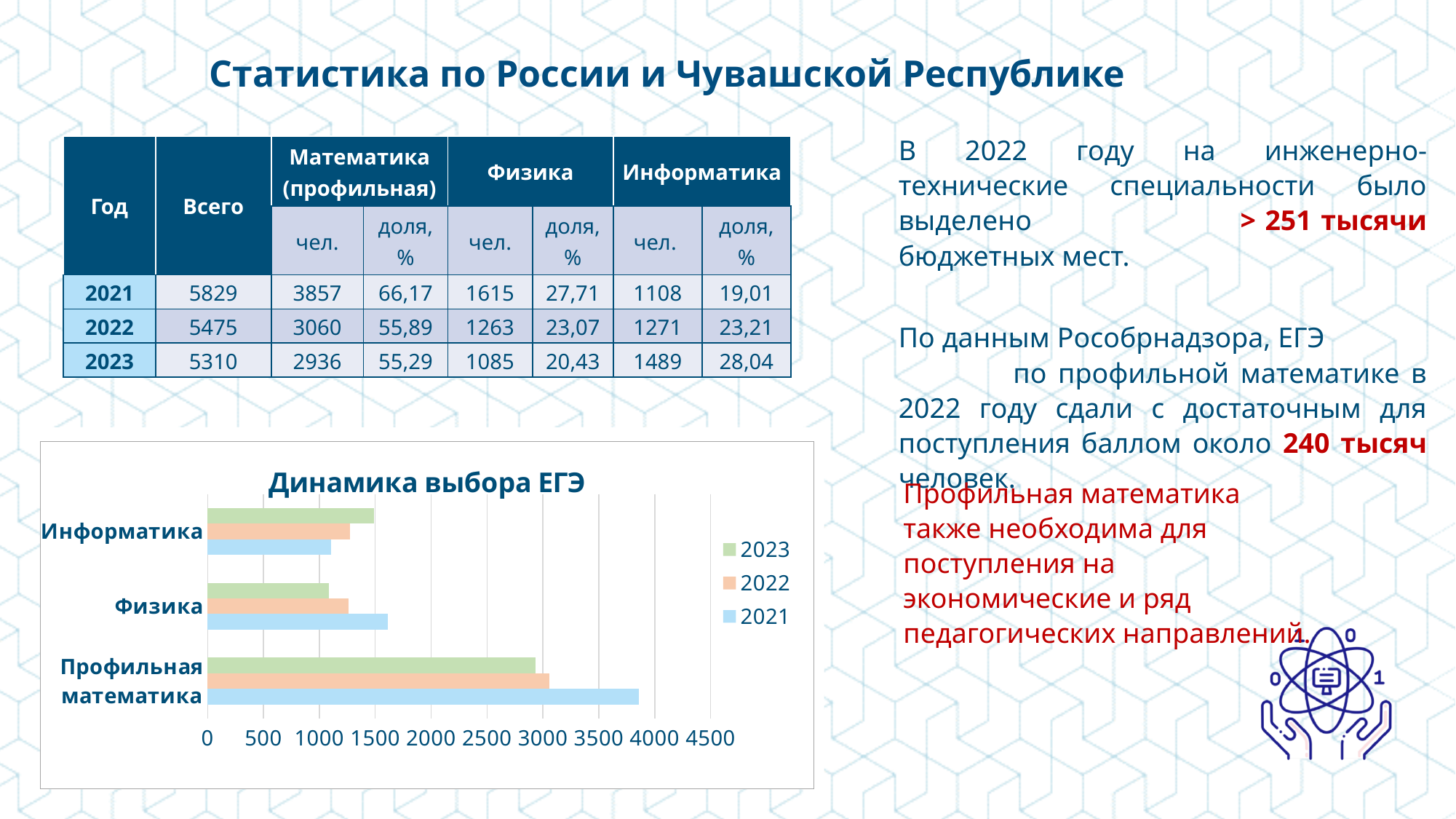
For Информатика, do the values rise or fall from 2021 to 2023? rise What kind of chart is shown on the slide? bar chart How many series does the chart legend list? 3 Is the 2021 value for Физика greater or less than 1500? greater Which subject has the highest value for 2021 in the chart? Профильная математика Which subject has the lowest value for 2023 in the chart? Физика What is the title of the chart? Динамика выбора ЕГЭ For Физика, which is larger: the 2021 value or the 2023 value? 2021 Is the 2021 value for Информатика greater or less than 1500? less How many subject categories are shown on the chart? 3 Which colour represents the 2021 series in the chart? blue Is the 2021 value for Профильная математика greater or less than 3500? greater